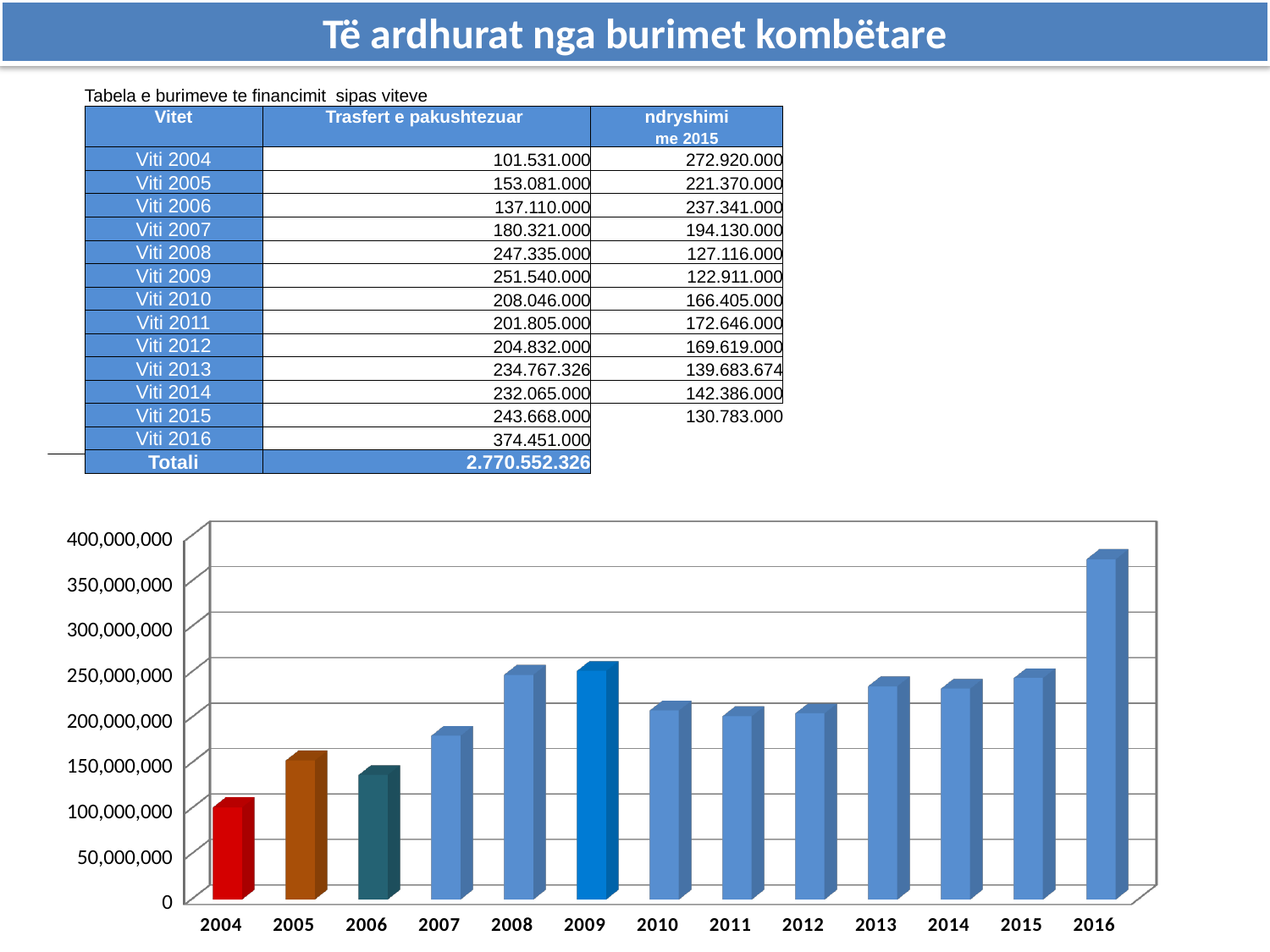
Is the value for 2008 in the bar chart greater or less than 200,000,000? greater According to the table on the slide, what is the value for Viti 2016 (Trasfert e pakushtezuar)? 374.451.000 What kind of chart is shown at the bottom of the slide? bar chart How many years are plotted on the x axis of the bar chart? 13 Which year has the tallest bar in the chart? 2016 What colour is the bar for 2004 in the chart? red Is the value for 2016 in the bar chart greater or less than 350,000,000? greater In the bar chart, which bar is taller, 2007 or 2010? 2010 Which year has the shortest bar in the chart? 2004 In the bar chart, which bar is taller, 2005 or 2006? 2005 Is the value for 2004 in the bar chart greater or less than 150,000,000? less Do the bars rise or fall from 2004 to 2009? rise